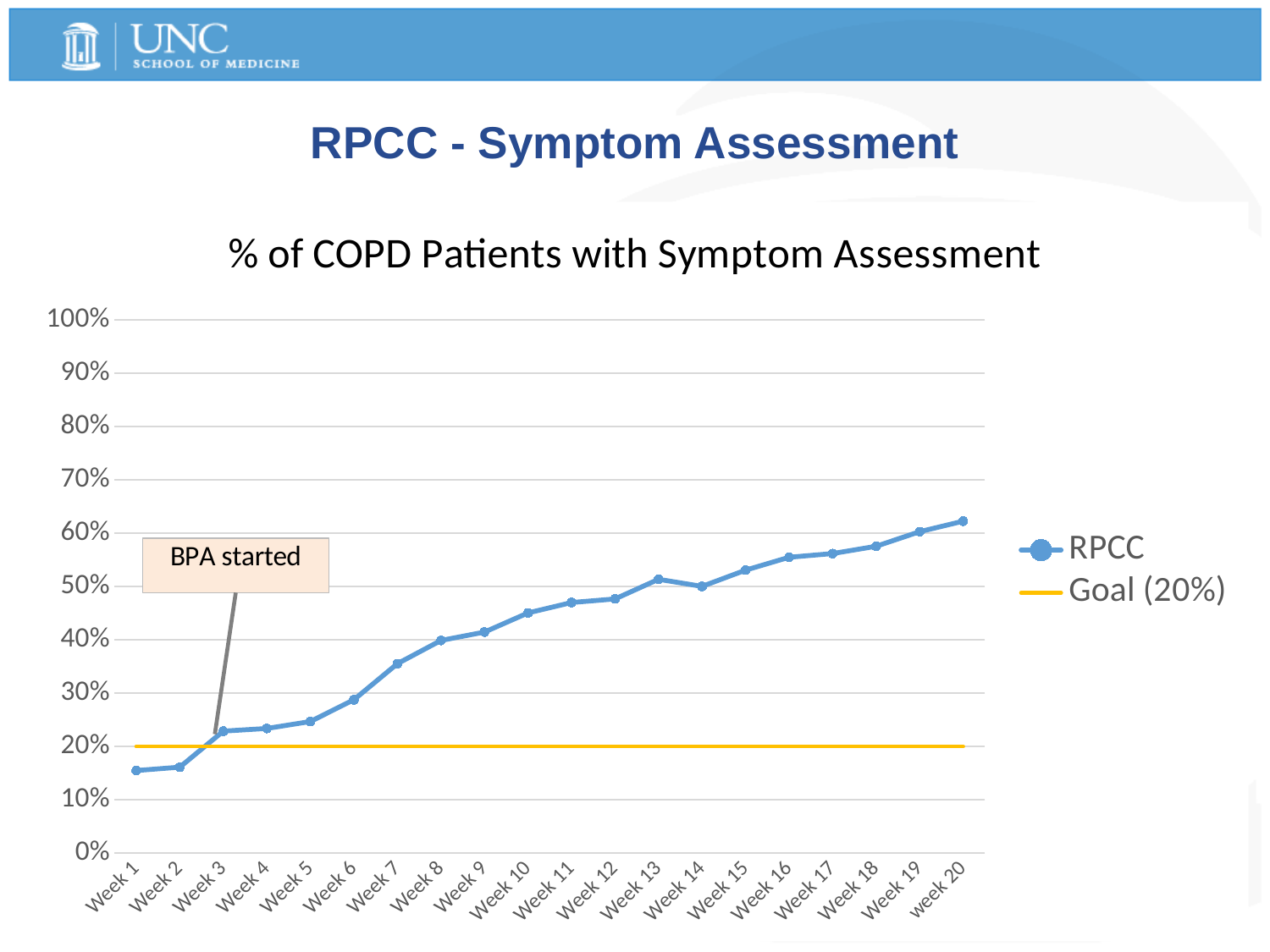
How many weeks are plotted along the x axis? 20 Do the RPCC values generally rise or fall from Week 1 to Week 20? Rise Which week has the highest RPCC value? Week 20 At which week does the annotation 'BPA started' point? Week 3 What kind of chart is shown on the slide? Line chart Which week has the lowest RPCC value? Week 1 How many series does the legend list? 2 What is the value of the Goal line? 20% Is the RPCC value for Week 20 greater or less than 60%? greater Is the RPCC value for Week 1 greater or less than 20%? less Is the RPCC value for Week 10 greater or less than 40%? greater Which is larger, the RPCC value for Week 8 or for Week 5? Week 8